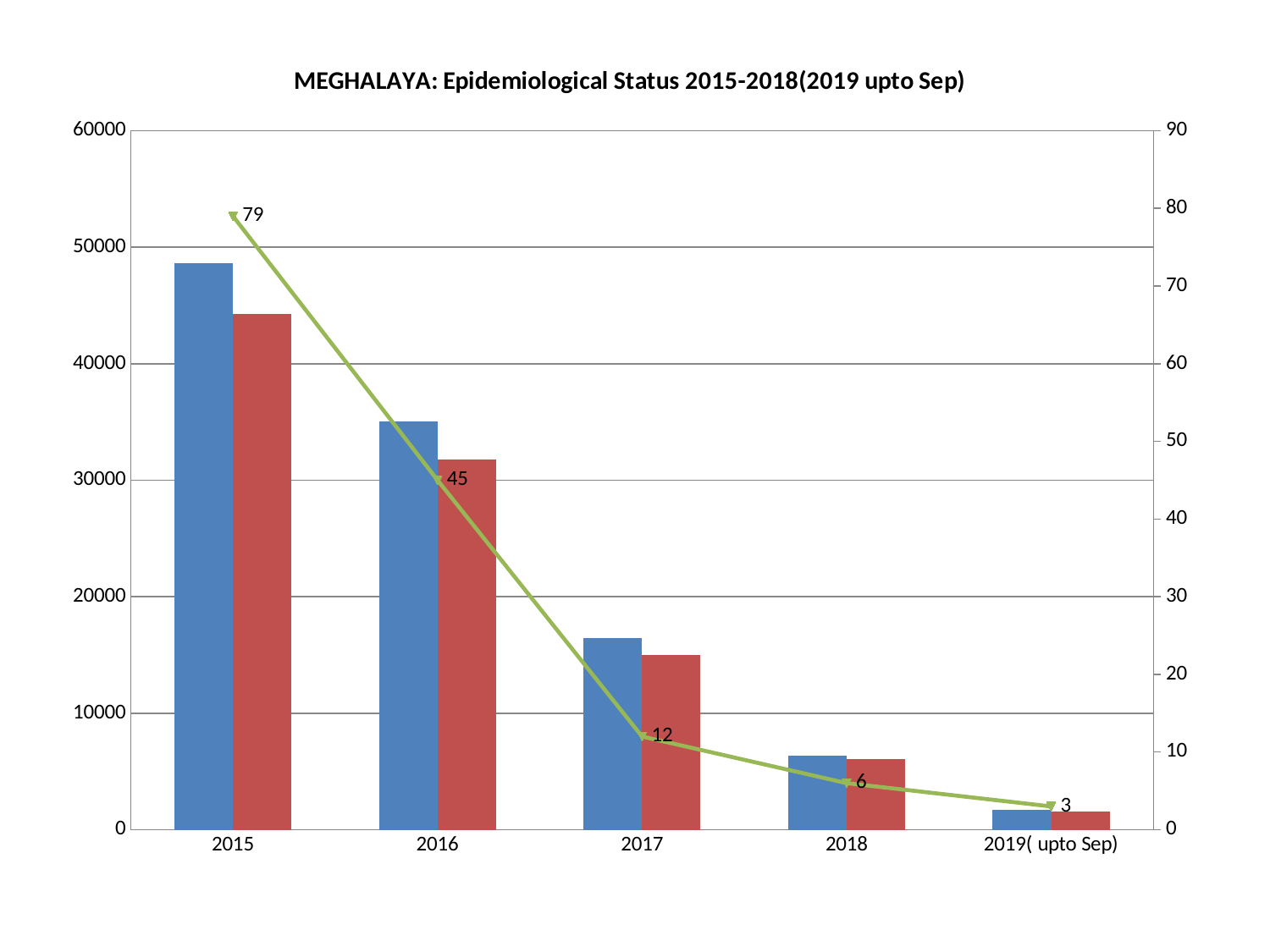
How many categories are shown on the x axis? 5 In which year does the green line reach its highest value? 2015 What is the difference between the green line values for 2015 and 2016? 34 Do the green line values rise or fall from 2015 to 2019( upto Sep)? Fall In which category does the green line reach its lowest value? 2019( upto Sep) What kind of chart is shown on the slide? Combined bar and line chart What value does the green line show for 2015? 79 What value does the green line show for 2019( upto Sep)? 3 What value does the green line show for 2017? 12 What is the title of the chart? MEGHALAYA: Epidemiological Status 2015-2018(2019 upto Sep) Which is larger for 2016, the blue bar or the red bar? The blue bar Is the value of the blue bar for 2015 greater or less than 40000? greater